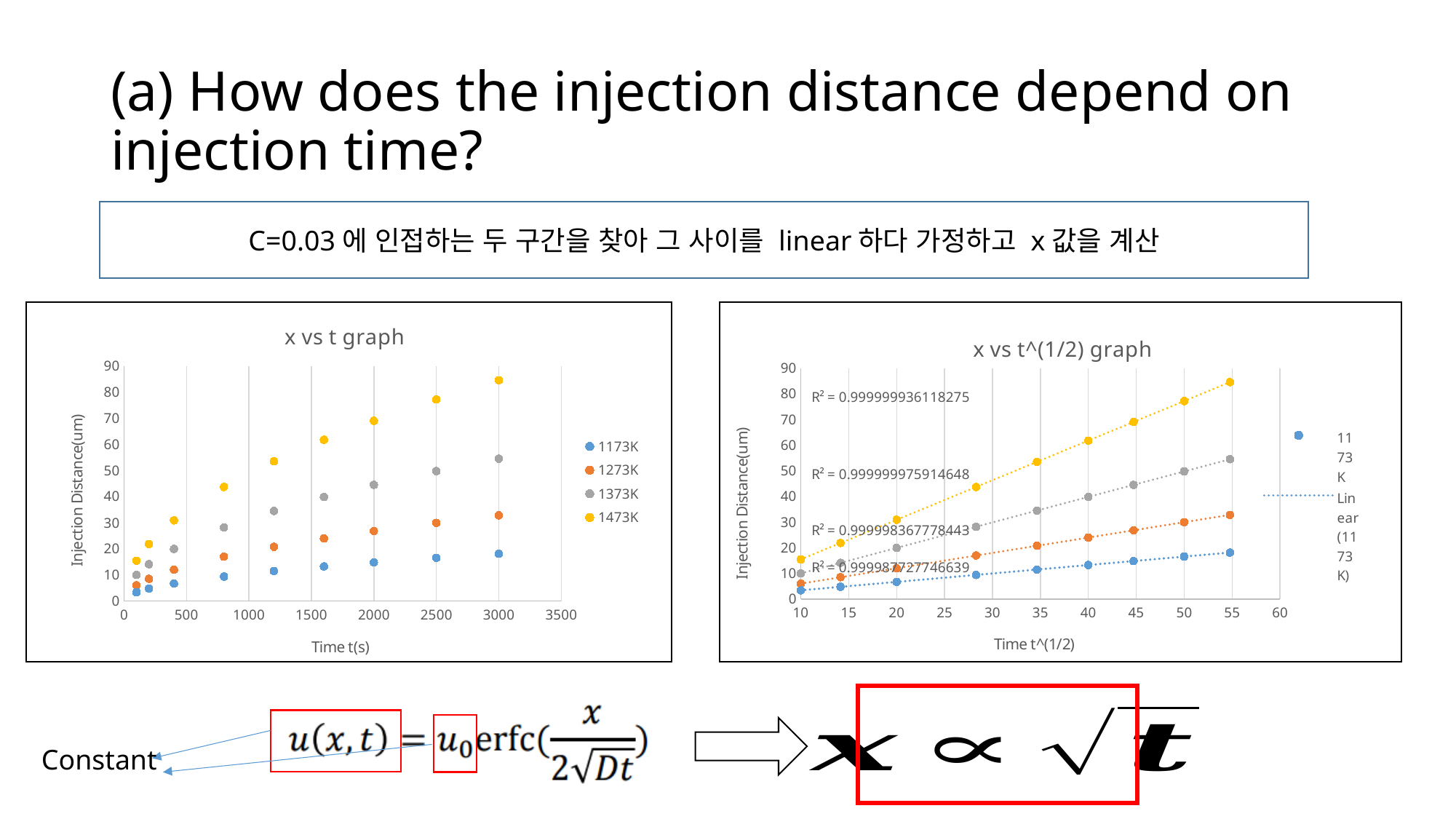
In the "x vs t graph", is the injection distance for 1373K at t = 3000 s greater or less than 50? greater In the "x vs t graph", does the injection distance rise or fall as time increases? rise What kind of chart is the "x vs t graph" on the left? scatter chart How many series does the legend of the "x vs t graph" list? 4 In the "x vs t graph", is the injection distance for 1473K at t = 3000 s greater or less than 80? greater In the "x vs t graph", which is larger at t = 2000 s: the value for 1273K or the value for 1373K? 1373K In the "x vs t graph", which series has the highest injection distance at t = 3000 s? 1473K What is the x-axis label of the chart on the right? Time t^(1/2) In the "x vs t graph", is the injection distance for 1173K at t = 3000 s greater or less than 20? less In the "x vs t graph", which series has the lowest injection distance at t = 3000 s? 1173K How many data points does each series have in the "x vs t graph"? 9 What is the title of the chart on the right? x vs t^(1/2) graph